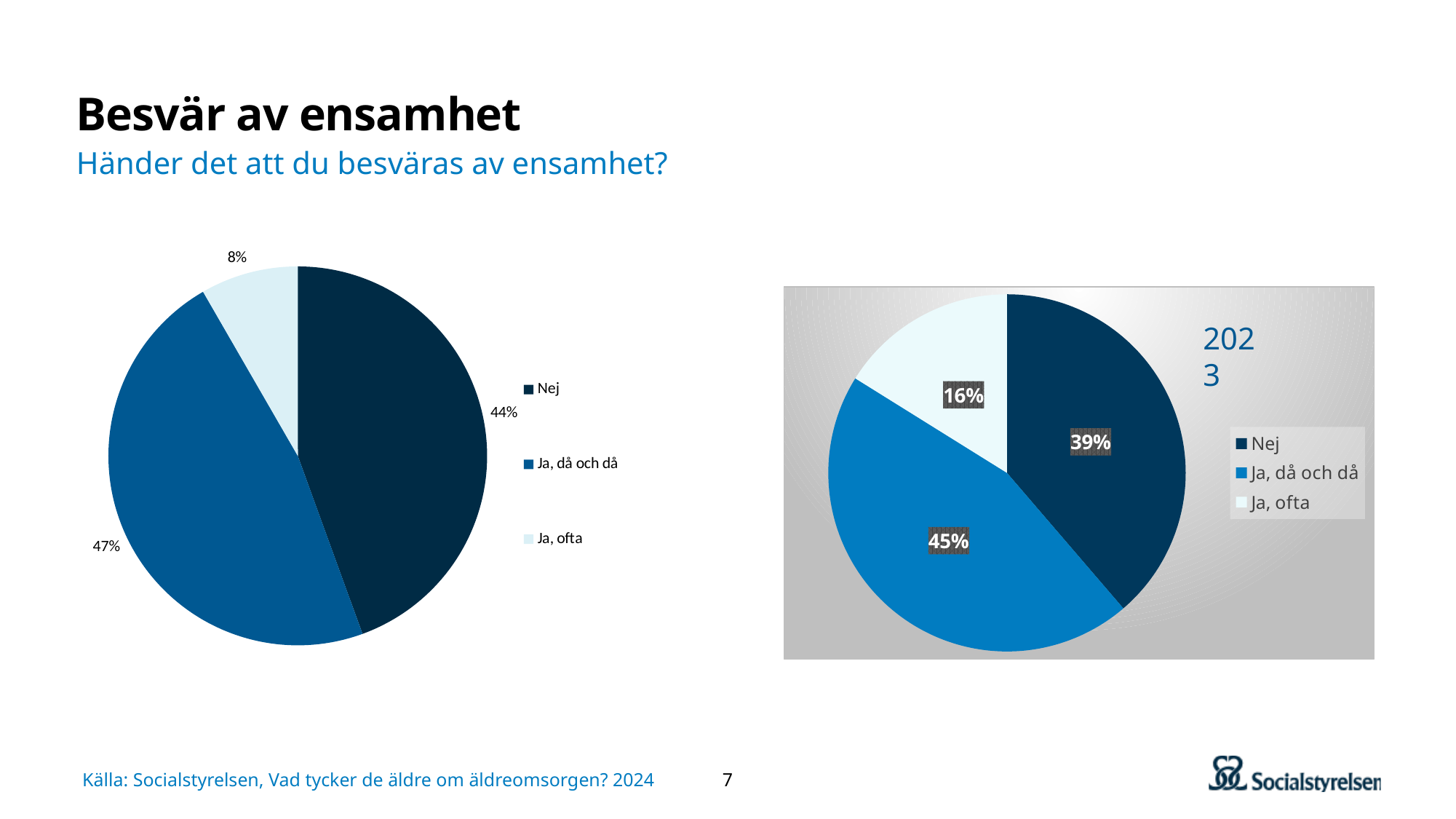
What year label is shown on the right pie chart? 2023 In the left pie chart, which category has the largest share? Ja, då och då In the right pie chart (2023), what is the value for "Ja, då och då"? 45% In the left pie chart, what is the value for "Nej"? 44% In the right pie chart (2023), which is larger, "Nej" or "Ja, då och då"? Ja, då och då In the right pie chart (2023), what is the value for "Ja, ofta"? 16% In the right pie chart (2023), what is the difference between "Nej" and "Ja, ofta"? 23% What kind of chart is the right chart (2023)? Pie chart How many categories does the left pie chart show? 3 In the left pie chart, what is the value for "Ja, ofta"? 8% In the left pie chart, what is the difference between "Ja, då och då" and "Nej"? 3% In the right pie chart (2023), which category has the smallest share? Ja, ofta